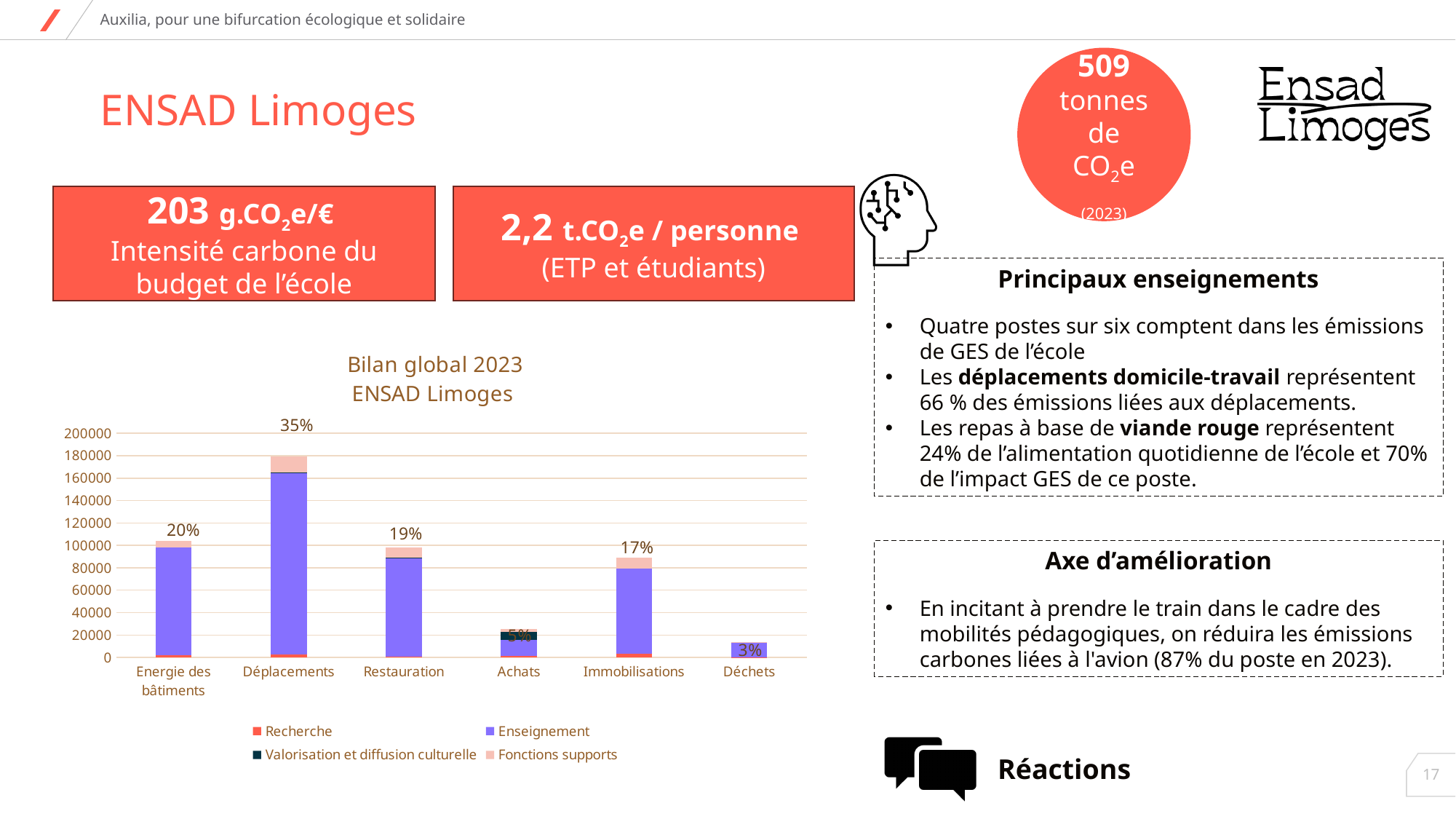
Which category has the lowest total emissions in the chart? Déchets What kind of chart is shown under the title "Bilan global 2023 ENSAD Limoges"? stacked bar chart What percentage label is shown above the Immobilisations bar? 17% Which category has the highest total emissions in the chart? Déplacements Which series is shown in purple in the chart legend? Enseignement What percentage label is shown above the Déchets bar? 3% What percentage label is shown above the Energie des bâtiments bar? 20% How many categories are shown on the x axis of the chart? 6 What percentage label is shown above the Déplacements bar? 35% How many series does the chart legend list? 4 Is the total value for Déplacements greater or less than 160000? greater